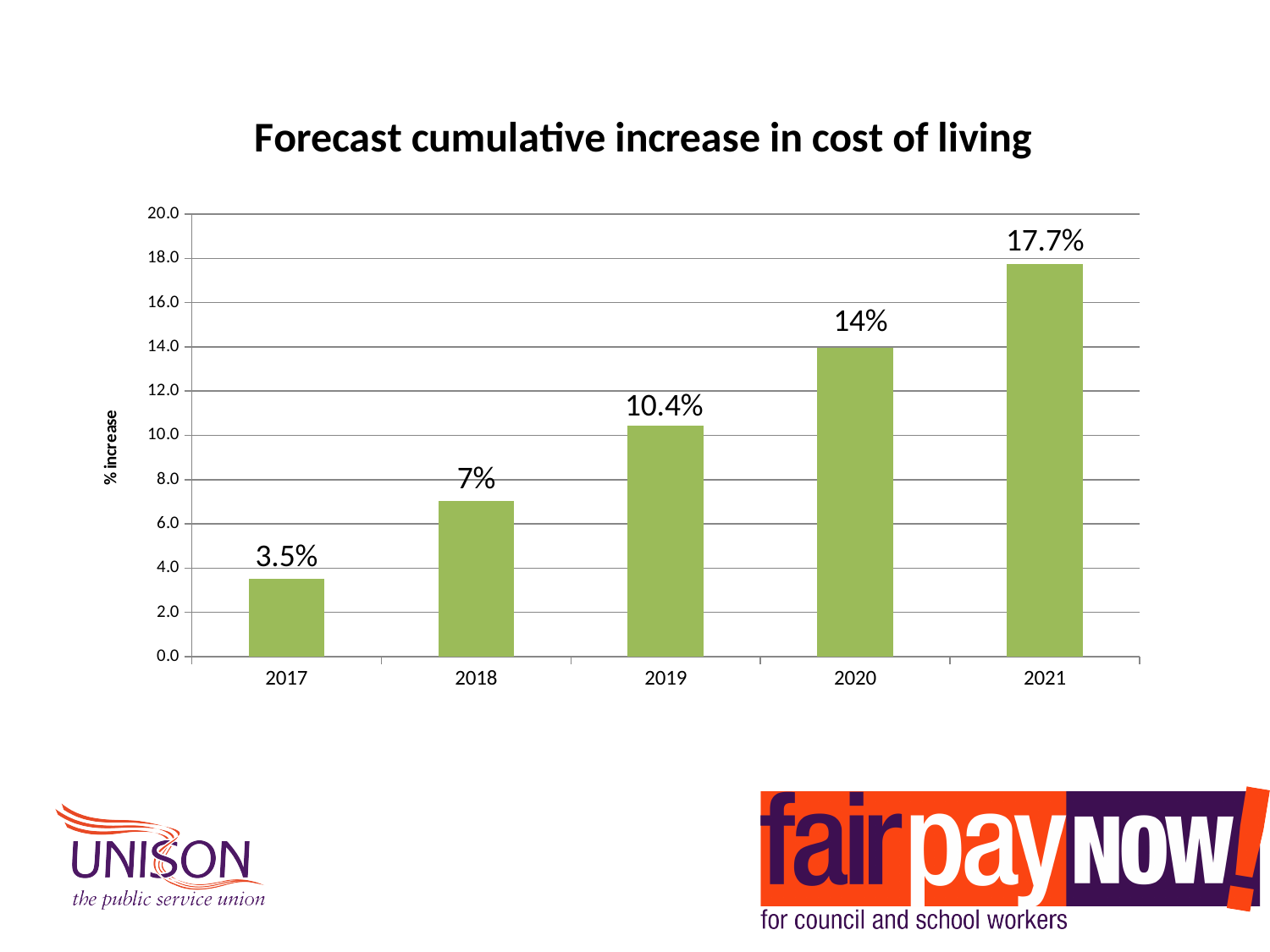
Which year has the lowest forecast cumulative increase? 2017 Is the value for 2020 greater or less than 12.0? greater What kind of chart is shown on the slide? bar chart Which year has the highest forecast cumulative increase? 2021 Which is larger, the value for 2019 or the value for 2020? 2020 What is the difference between the values for 2018 and 2017? 3.5% What is the difference between the values for 2021 and 2020? 3.7% What is the forecast cumulative increase in cost of living for 2019? 10.4% What is the value shown for 2021? 17.7% Do the values rise or fall from 2017 to 2021? rise What is the value shown for 2017? 3.5% How many years are shown on the x axis? 5